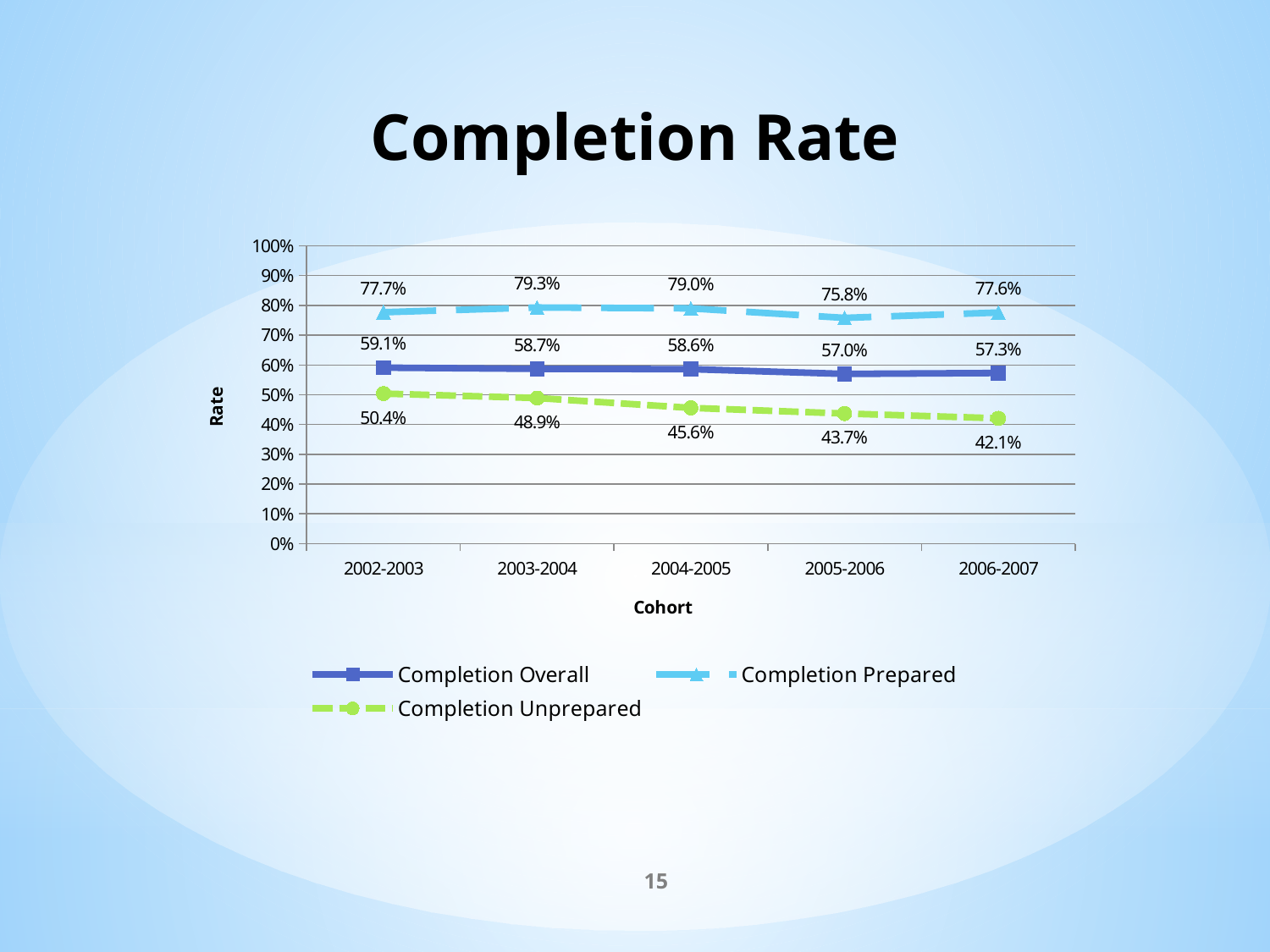
Which is larger, the Completion Overall rate for 2002-2003 or for 2006-2007? 2002-2003 What kind of chart is shown on the slide? line chart Which cohort has the highest Completion Prepared rate? 2003-2004 How many cohorts are shown on the x axis? 5 What is the Completion Overall rate for the 2005-2006 cohort? 57.0% Is the Completion Unprepared rate for the 2005-2006 cohort greater or less than 50%? less How many series does the legend list? 3 What is the Completion Unprepared rate for the 2006-2007 cohort? 42.1% Does the Completion Unprepared rate rise or fall from the 2002-2003 cohort to the 2006-2007 cohort? fall What is the difference between the Completion Prepared and Completion Unprepared rates for the 2004-2005 cohort? 33.4% What is the Completion Prepared rate for the 2003-2004 cohort? 79.3% Which cohort has the lowest Completion Unprepared rate? 2006-2007